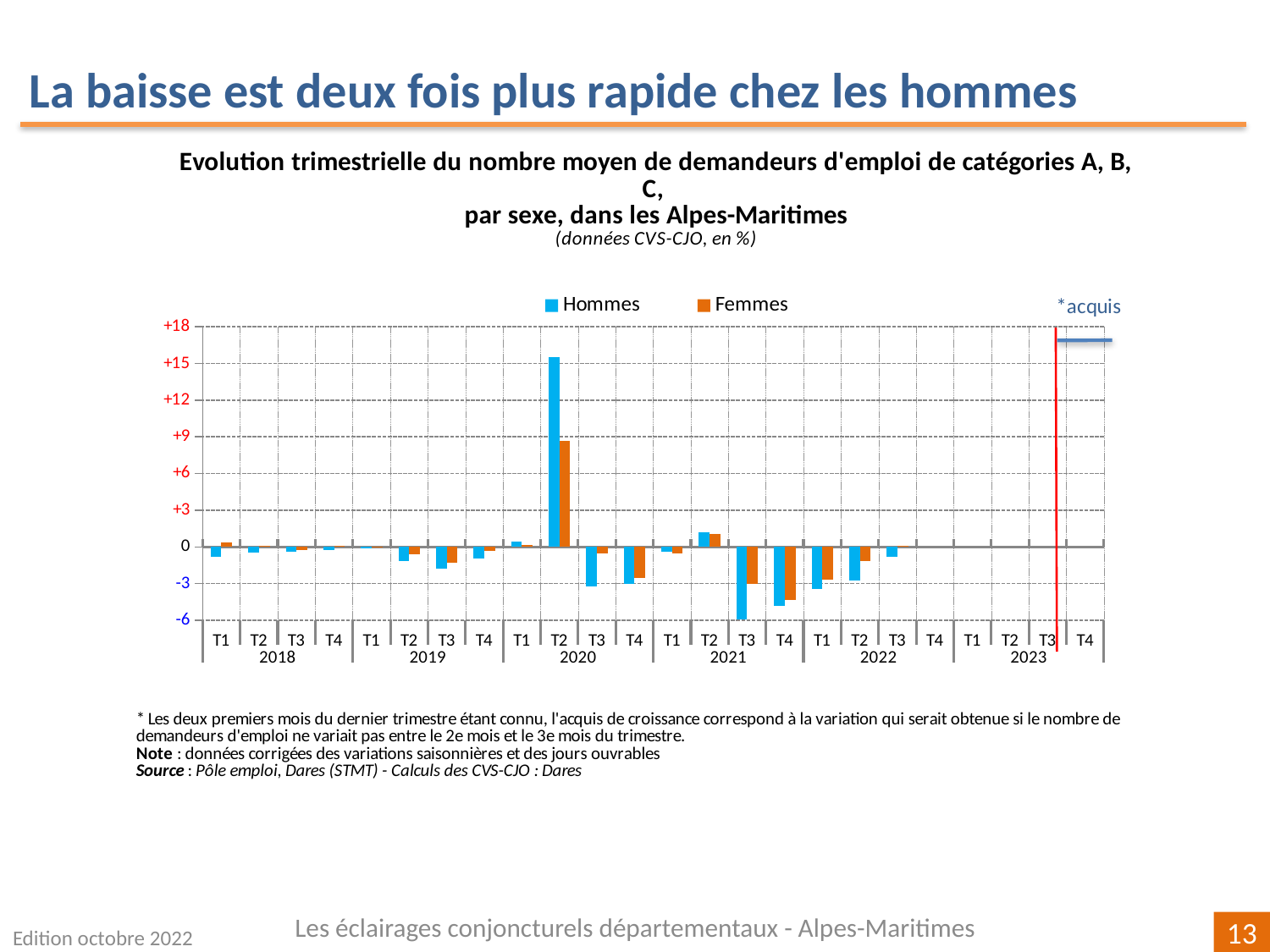
Is the Hommes value for T2 2020 greater or less than +12? greater Which series are listed in the legend? Hommes and Femmes How many years are labelled along the x axis? 6 Which colour represents the Femmes series? orange How many series does the legend list? 2 What kind of chart is shown on the slide? bar chart In which quarter does the Hommes series reach its lowest value? T3 2021 In which quarter does the Hommes series reach its highest value? T2 2020 In T2 2020, which series has the larger value, Hommes or Femmes? Hommes Is the Femmes value for T2 2020 greater or less than +6? greater Is the Hommes value for T4 2021 greater or less than -3? less